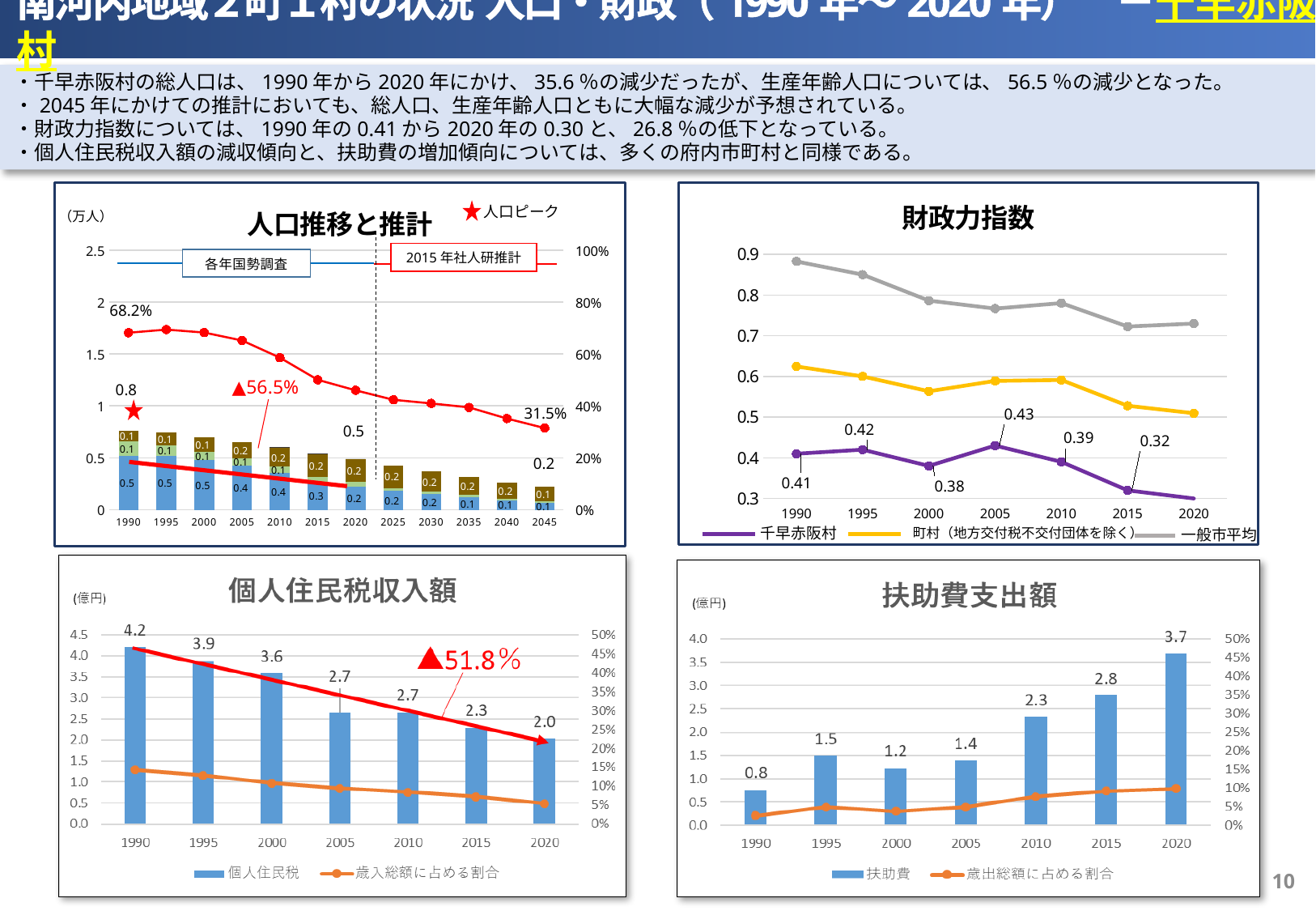
In the 財政力指数 chart (top right), what is the value for 千早赤阪村 in 2015? 0.32 In the 財政力指数 chart (top right), what is the value for 千早赤阪村 in 2005? 0.43 In the 扶助費支出額 chart (bottom right), which year has the lowest 扶助費 bar? 1990 In the 扶助費支出額 chart (bottom right), do the 扶助費 bar values generally rise or fall from 1990 to 2020? rise In the 個人住民税収入額 chart (bottom left), what is the value of the 個人住民税 bar for 1990? 4.2 In the 人口推移と推計 chart (top left), how many years are shown on the x axis? 12 In the 個人住民税収入額 chart (bottom left), what is the value of the 個人住民税 bar for 2020? 2.0 In the 扶助費支出額 chart (bottom right), which year has the highest 扶助費 bar? 2020 In the 財政力指数 chart (top right), how many series does the legend list? 3 In the 財政力指数 chart (top right), is the 一般市平均 value for 1990 greater or less than 0.8? greater In the 扶助費支出額 chart (bottom right), what is the value of the 扶助費 bar for 2010? 2.3 In the 個人住民税収入額 chart (bottom left), what is the difference between the 1990 and 2020 bar values? 2.2